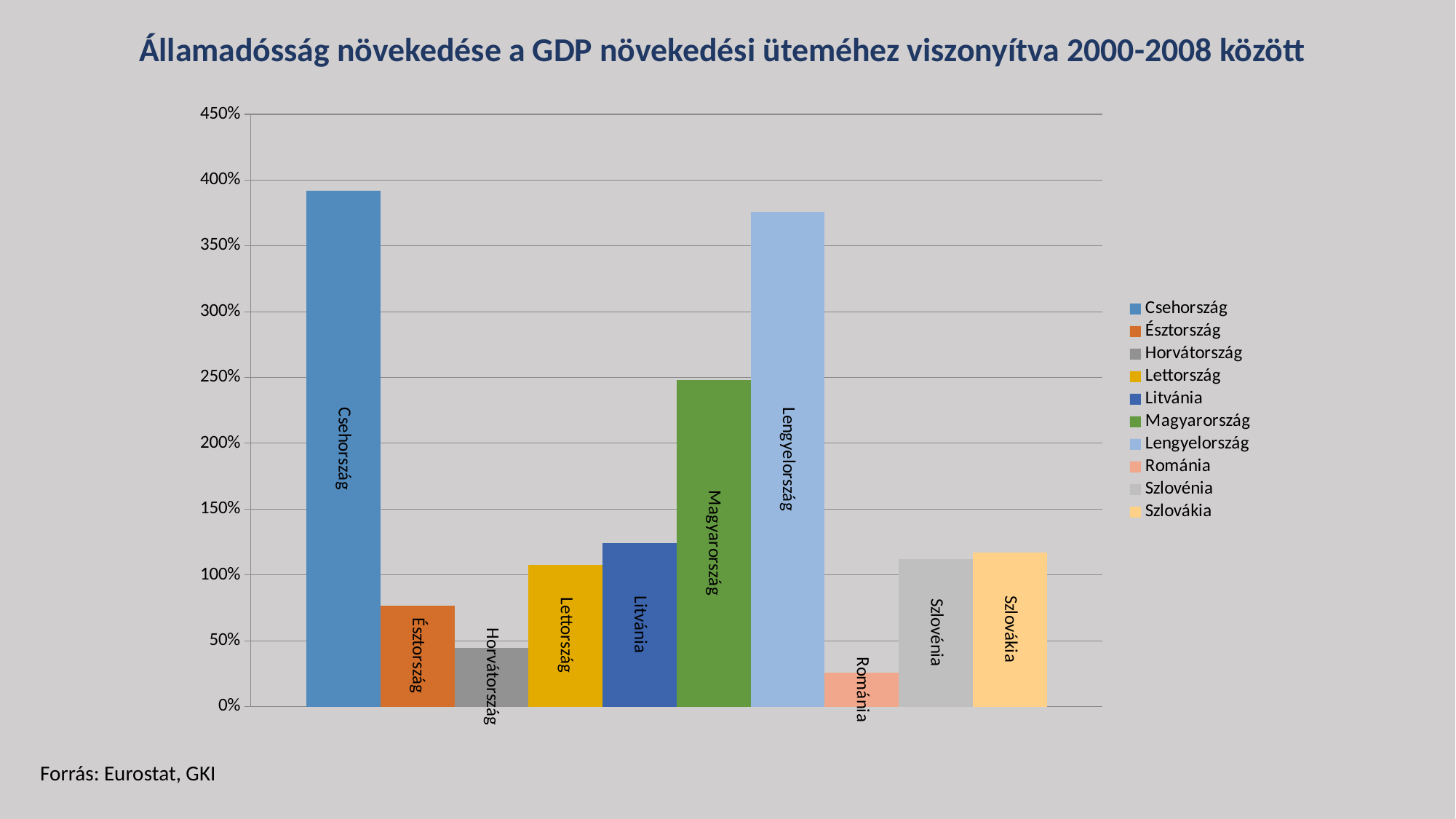
Which country has the highest value in the chart? Csehország Is the value for Románia greater or less than 50%? less How many countries (bars) are shown in the chart? 10 Is the value for Horvátország greater or less than 50%? less What is the title of the chart? Államadósság növekedése a GDP növekedési üteméhez viszonyítva 2000-2008 között How many entries does the legend list? 10 Which is larger, the value for Lengyelország or the value for Észtország? Lengyelország Which country has the lowest value in the chart? Románia Which is larger, the value for Magyarország or the value for Litvánia? Magyarország Is the value for Magyarország greater or less than 200%? greater What kind of chart is shown on the slide? bar chart